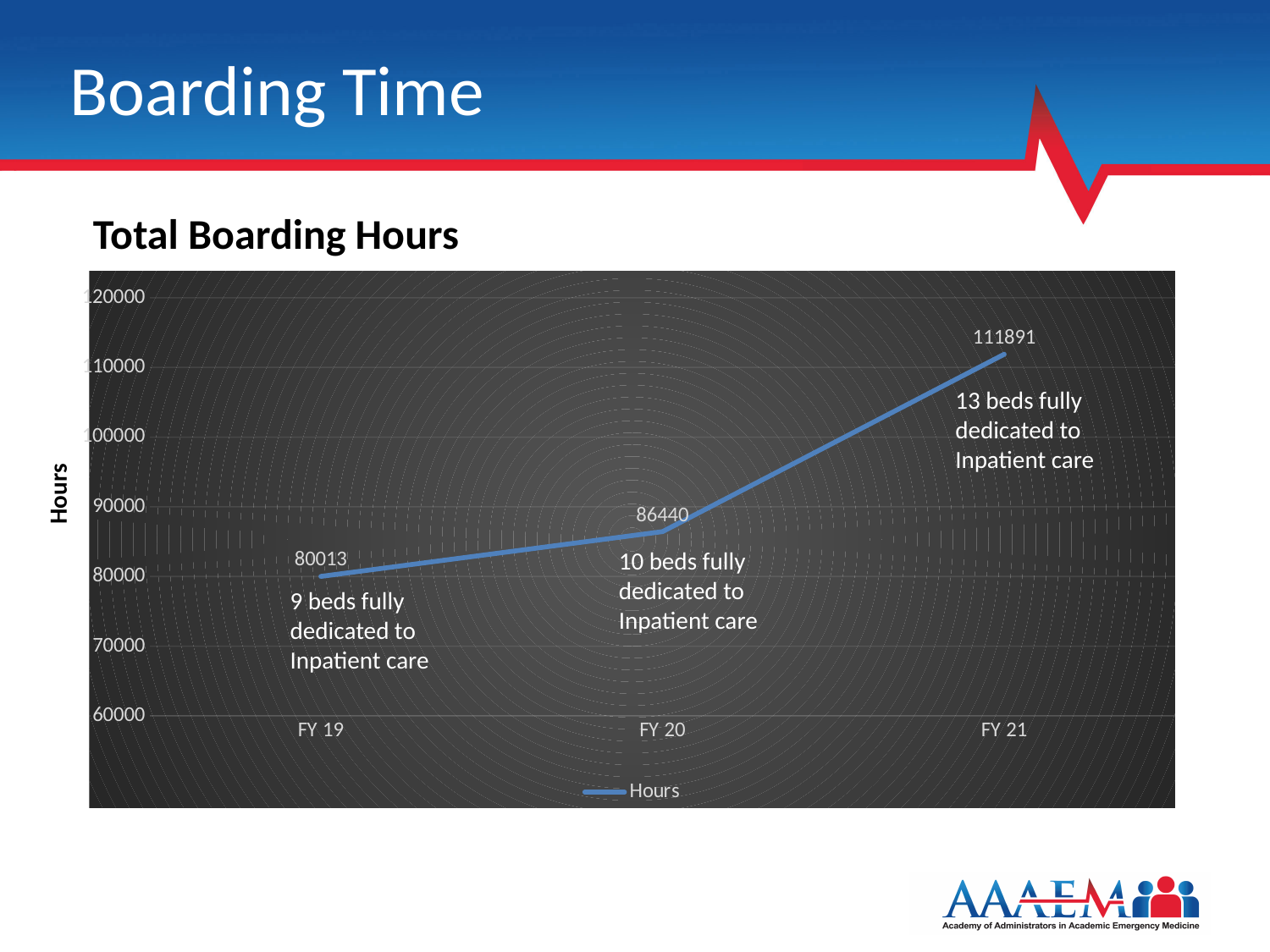
Which fiscal year has the lowest total boarding hours? FY 19 What is the value for FY 19? 80013 Do the values rise or fall from FY 19 to FY 21? Rise What is the value for FY 21? 111891 What is the value for FY 20? 86440 Which is larger, the value for FY 20 or the value for FY 19? FY 20 What kind of chart is shown? Line chart What is the difference between the FY 21 and FY 20 values? 25451 Is the value for FY 21 greater or less than 110000? greater What is the difference between the FY 20 and FY 19 values? 6427 How many fiscal years are plotted on the chart? 3 Which fiscal year has the highest total boarding hours? FY 21